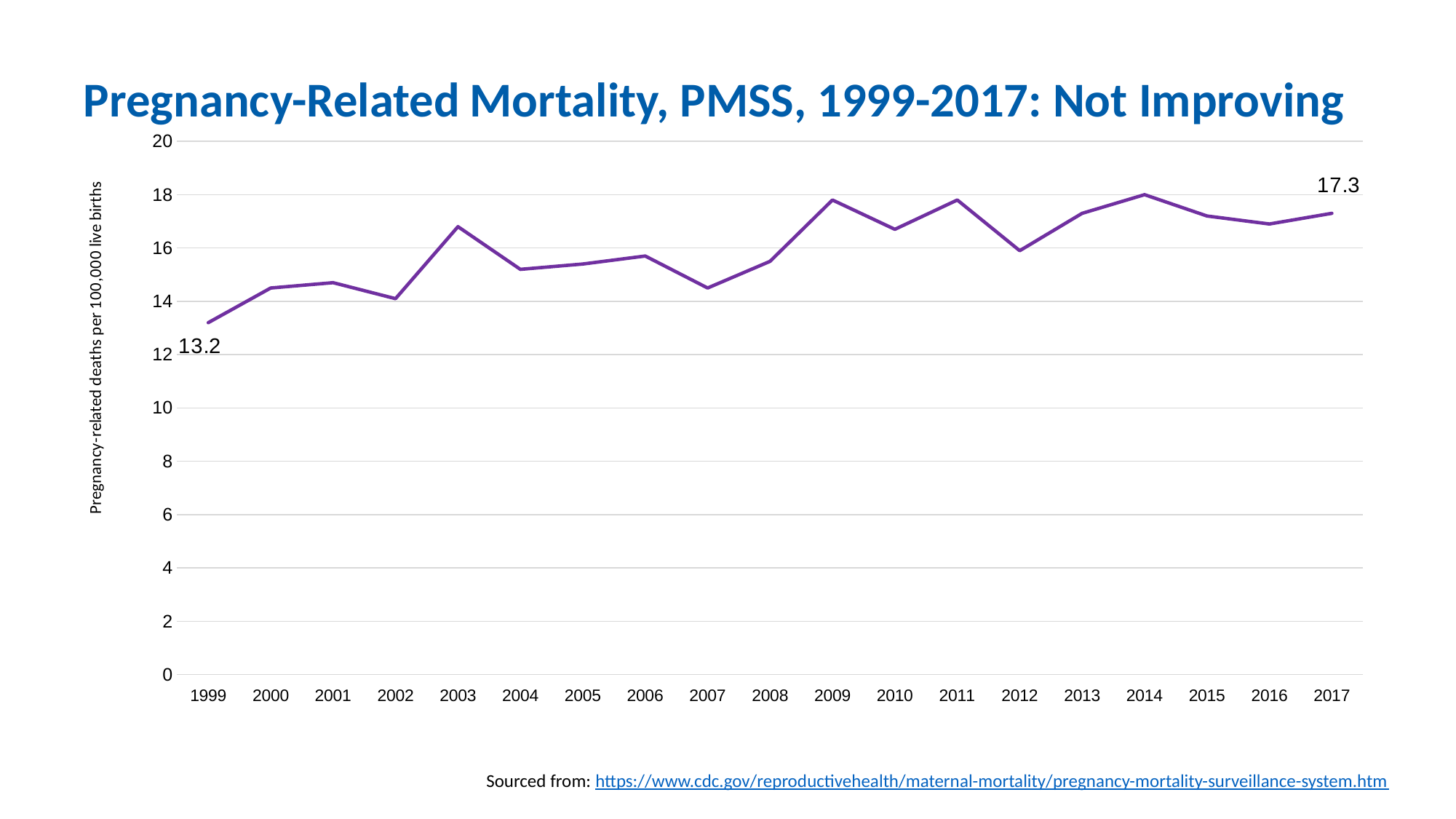
What is the value for 2017? 17.3 Which is larger, the value for 2002 or the value for 2003? 2003 Overall, do the values rise or fall from 1999 to 2017? rise Which is larger, the value for 1999 or the value for 2017? 2017 What is the value for 1999? 13.2 Is the value for 2014 greater or less than 16? greater What kind of chart is shown on the slide? line chart How many years are plotted on the x axis? 19 What is the difference between the values for 2017 and 1999? 4.1 Which year has the lowest value? 1999 Is the value for 2002 greater or less than 16? less Is the value for 2007 greater or less than 16? less